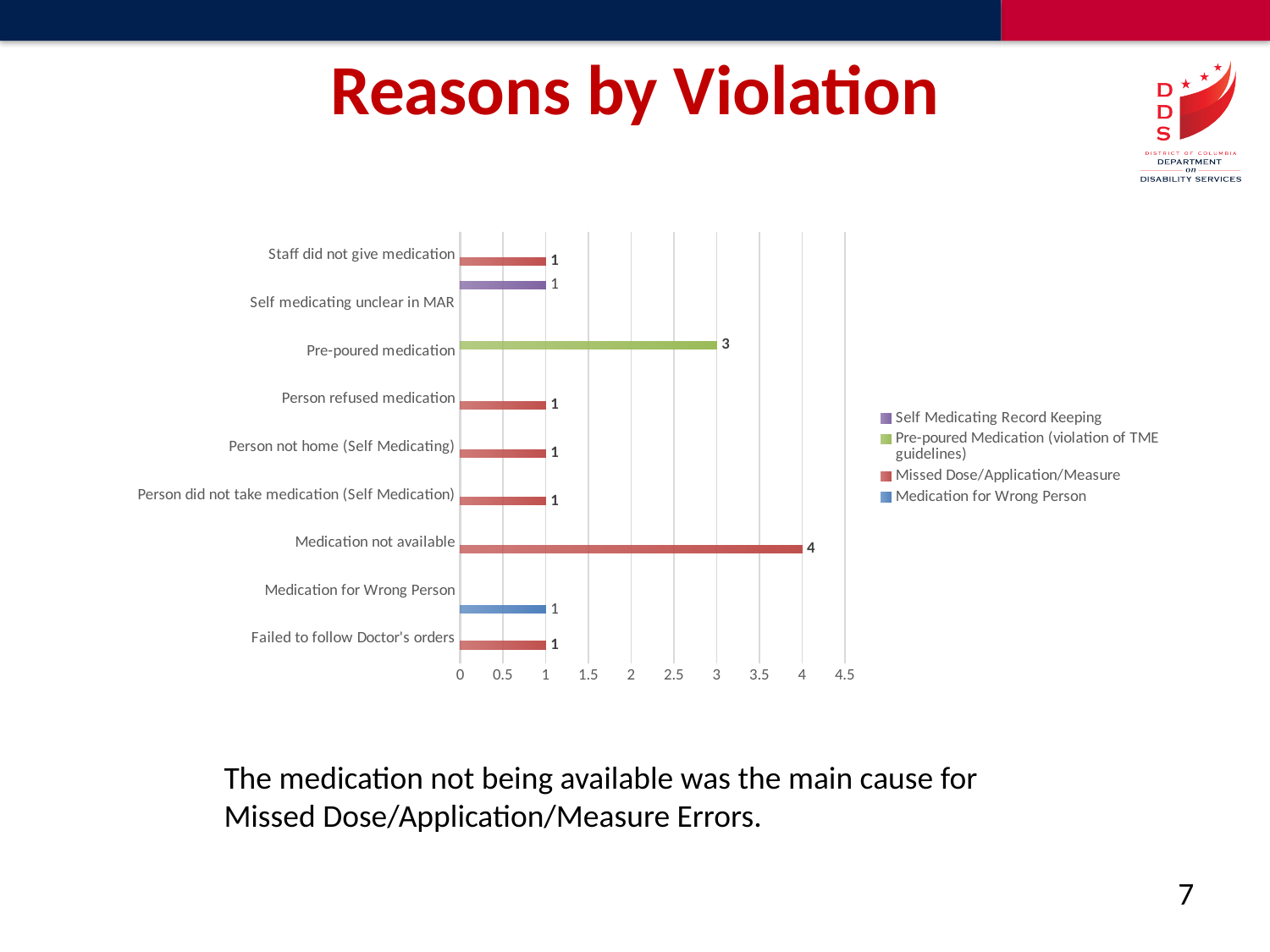
What is the difference between the values for Medication not available and Pre-poured medication? 1 How many series does the legend list? 4 Which category has the highest value? Medication not available What is the value for Pre-poured medication? 3 What is the value for Person refused medication? 1 What is the value for Failed to follow Doctor's orders? 1 Is the value for Medication not available greater or less than 3.5? greater What is the title of the slide containing the chart? Reasons by Violation What kind of chart is shown on the slide? bar chart What is the value for Medication not available? 4 Which is larger, the value for Pre-poured medication or the value for Person not home (Self Medicating)? Pre-poured medication How many categories are listed on the vertical axis? 9